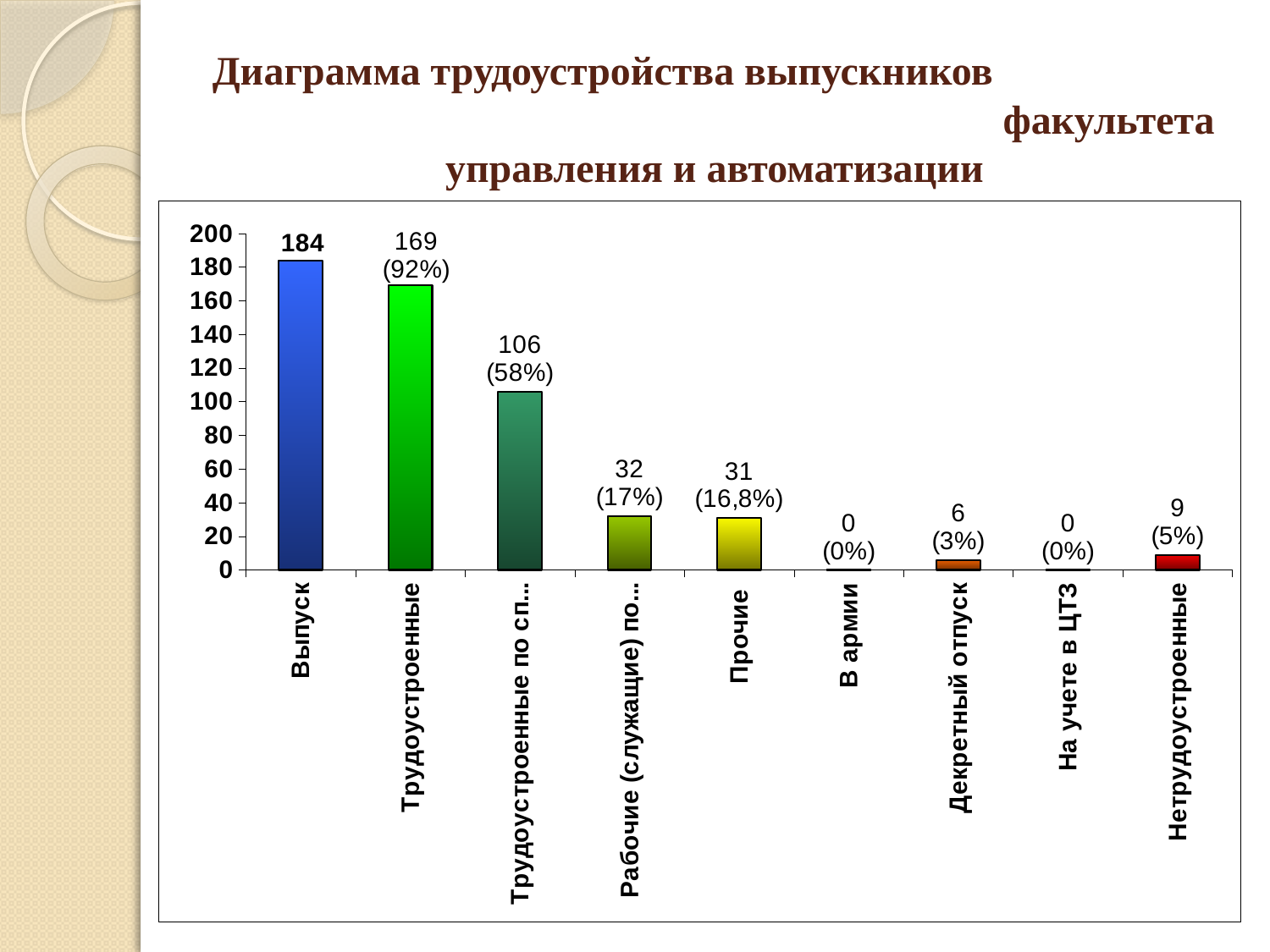
How many categories are shown on the x axis? 9 What kind of chart is shown on the slide? Bar chart What percentage is shown for Трудоустроенные? 92% Which category has the highest value? Выпуск What is the value for Трудоустроенные? 169 Which is larger, the value for Декретный отпуск or the value for Нетрудоустроенные? Нетрудоустроенные What is the value for Прочие? 31 What is the value for Выпуск? 184 What is the value for В армии? 0 What is the difference between the values for Выпуск and Трудоустроенные? 15 What is the value for Декретный отпуск? 6 What is the value for Нетрудоустроенные? 9